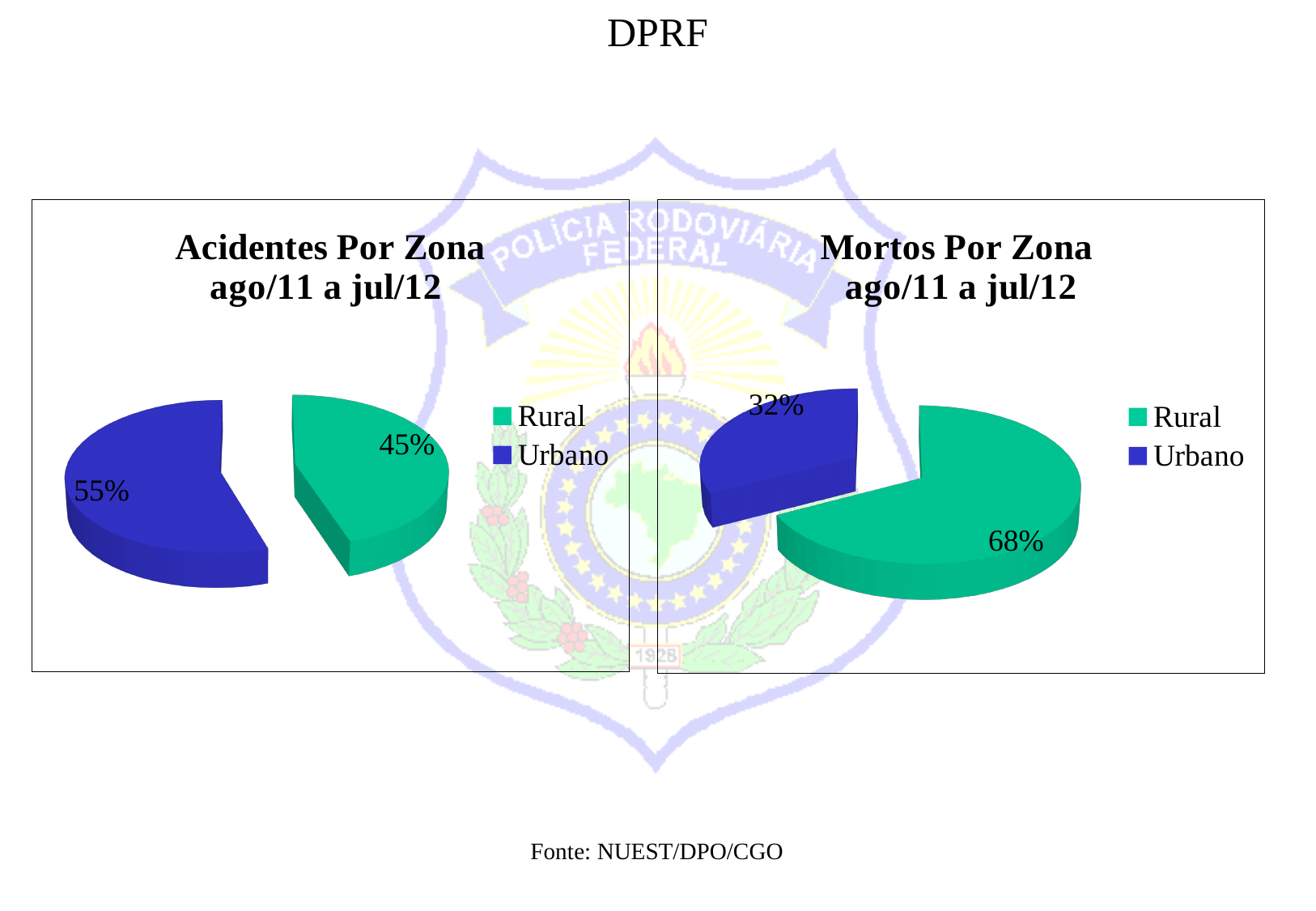
In the 'Mortos Por Zona ago/11 a jul/12' chart, which zone has the smaller share? Urbano What kind of chart is the 'Acidentes Por Zona ago/11 a jul/12' chart? Pie chart In the 'Acidentes Por Zona ago/11 a jul/12' chart, what is the difference in percentage points between Urbano and Rural? 10 How many slices does the 'Mortos Por Zona ago/11 a jul/12' pie chart have? 2 Is the Rural share larger in the 'Acidentes Por Zona' chart or in the 'Mortos Por Zona' chart? Mortos Por Zona In the 'Mortos Por Zona ago/11 a jul/12' chart, what share is Urbano? 32% In the 'Mortos Por Zona ago/11 a jul/12' chart, what is the difference in percentage points between Rural and Urbano? 36 In the 'Acidentes Por Zona ago/11 a jul/12' chart, what share is Urbano? 55% In the 'Mortos Por Zona ago/11 a jul/12' chart, what colour is the Urbano slice? Blue In the 'Acidentes Por Zona ago/11 a jul/12' chart, what share is Rural? 45% In the 'Acidentes Por Zona ago/11 a jul/12' chart, which zone has the larger share? Urbano In the 'Mortos Por Zona ago/11 a jul/12' chart, what share is Rural? 68%